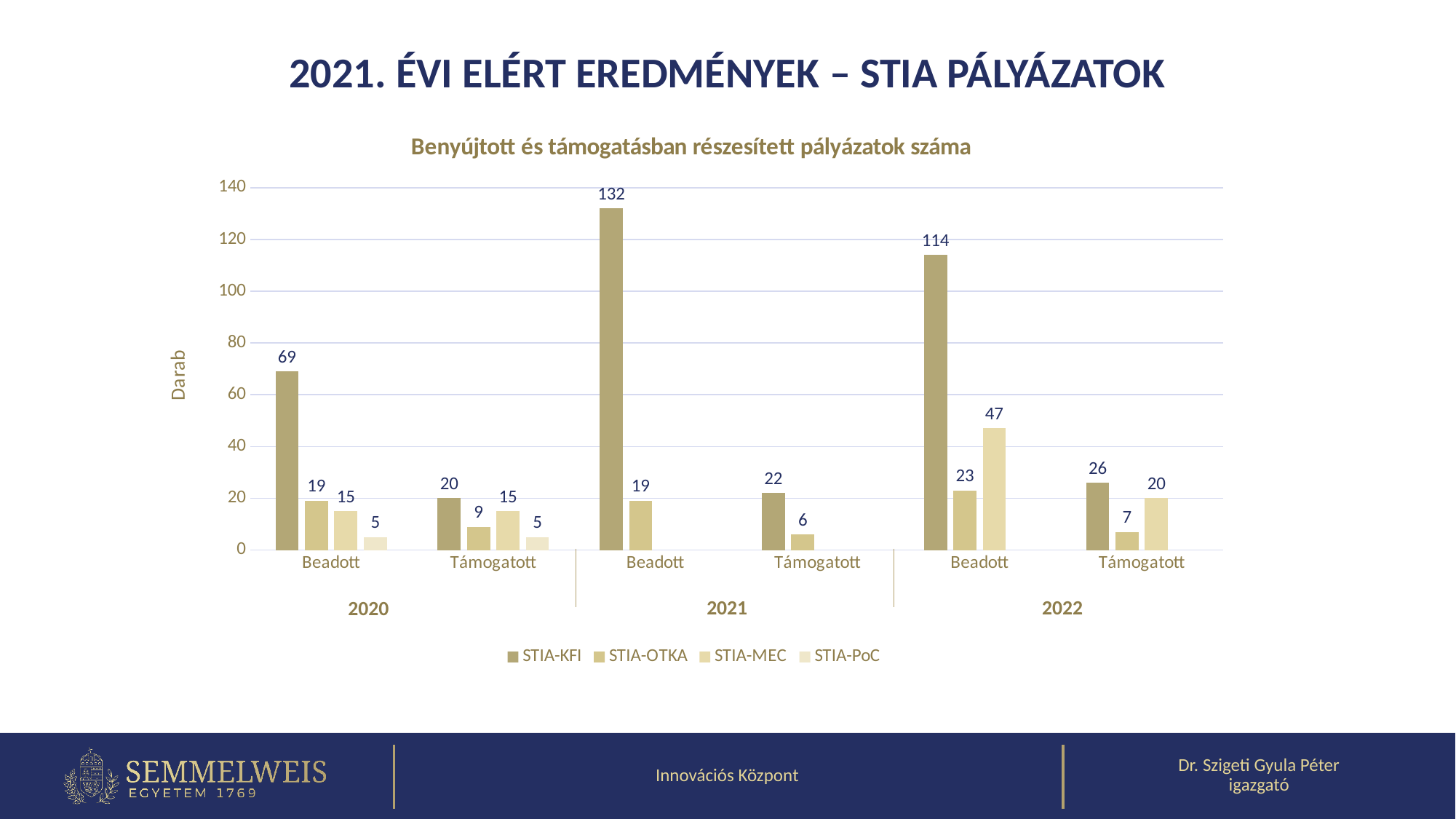
Which series has the lowest value in the 2020 Beadott group? STIA-PoC Which series has the highest value in the 2022 Beadott group? STIA-KFI Which is larger: STIA-KFI for 2020 Beadott or STIA-MEC for 2022 Beadott? STIA-KFI for 2020 Beadott What kind of chart is shown on the slide? Bar chart How many years are shown along the x axis? 3 What is the value for STIA-OTKA in the 2020 Támogatott group? 9 What is the title of the chart? Benyújtott és támogatásban részesített pályázatok száma What is the value for STIA-MEC in the 2022 Beadott group? 47 How many series does the legend list? 4 What is the value for STIA-KFI in the 2021 Beadott group? 132 What is the difference between the STIA-KFI values for 2021 Beadott and 2022 Beadott? 18 What is the label of the vertical axis? Darab